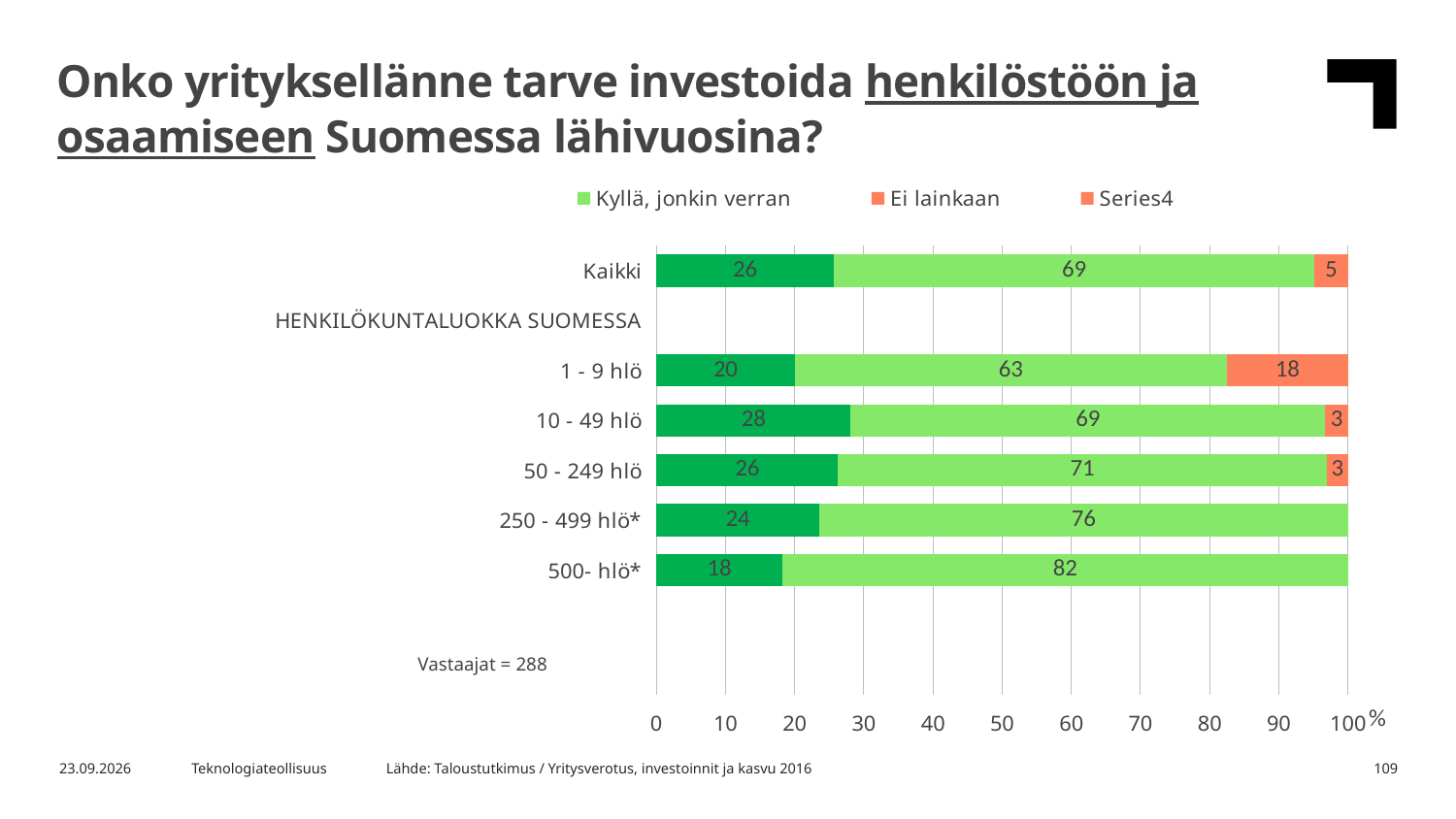
How many respondents (Vastaajat) does the slide report? 288 How many series does the legend list? 3 What is the value of "Ei lainkaan" for the 1 - 9 hlö category? 18 What type of chart is shown on the slide? Stacked bar chart What is the total of the stacked bar for Kaikki? 100 Which category has a larger "Ei lainkaan" value, Kaikki or 1 - 9 hlö? 1 - 9 hlö What is the value of "Kyllä, jonkin verran" for the 500- hlö* category? 82 What is the value of "Ei lainkaan" for the Kaikki category? 5 Which category has the lowest value for "Kyllä, jonkin verran"? 1 - 9 hlö What is the difference between the "Kyllä, jonkin verran" values for 500- hlö* and 1 - 9 hlö? 19 Which category has the highest value for "Kyllä, jonkin verran"? 500- hlö* How many categories (bars) are plotted in the chart? 6